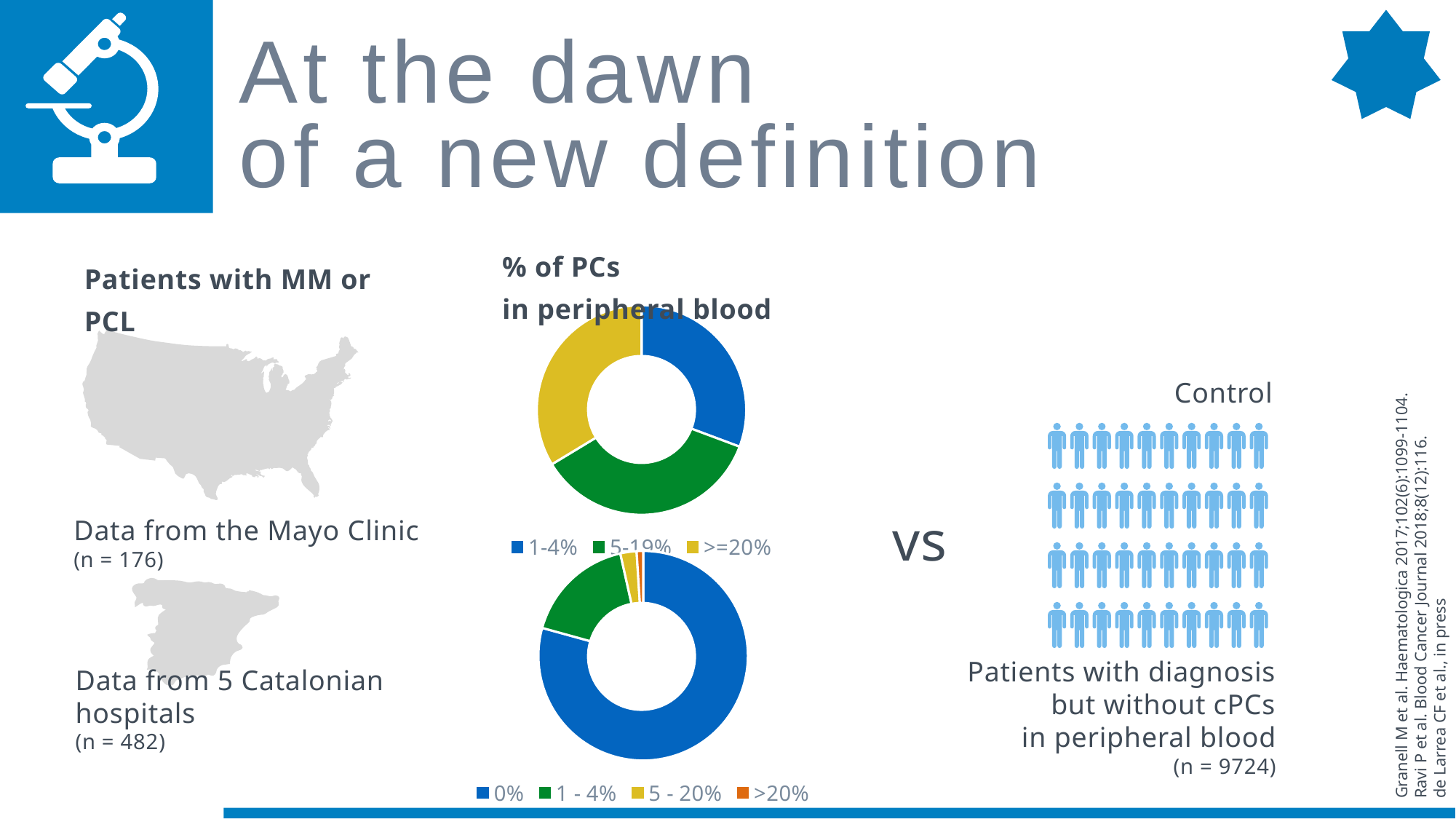
In the lower doughnut chart, which slice is larger: 5 - 20% or >20%? 5 - 20% In the lower doughnut chart, which category has the smallest slice? >20% What kind of chart is the upper chart under the heading '% of PCs in peripheral blood'? Doughnut chart In the lower doughnut chart, which category has the largest slice? 0% How many categories does the legend of the upper doughnut chart list? 3 In the lower doughnut chart, which slice is larger: 1 - 4% or 5 - 20%? 1 - 4% In the lower doughnut chart, which slice is larger: 0% or 1 - 4%? 0% What are the legend entries of the upper doughnut chart? 1-4%, 5-19%, >=20% What kind of chart is the lower chart under the heading '% of PCs in peripheral blood'? Doughnut chart In the lower doughnut chart, what colour represents the 0% category? Blue How many categories does the legend of the lower doughnut chart list? 4